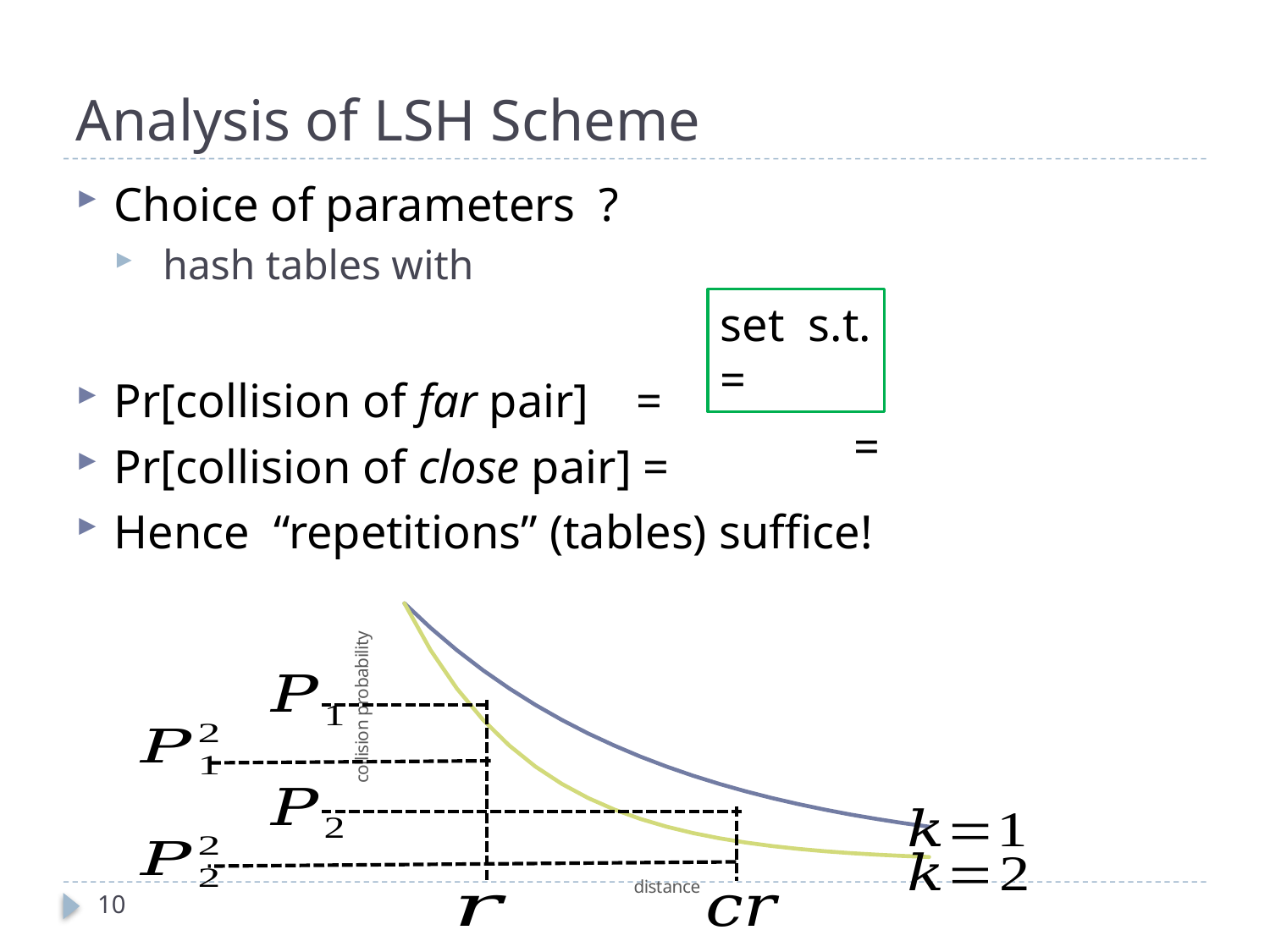
How many curves are plotted in the chart? 2 Which is larger on the chart, P1² or P2²? P1² What is the label of the y axis of the chart? collision probability Which curve passes through the point marked P2² at distance cr? k=2 What is the label of the x axis of the chart? distance Which curve drops off more steeply with distance, k=1 or k=2? k=2 Which is larger on the chart, P1 or P2? P1 As distance increases along the x axis, does collision probability rise or fall? fall Which curve passes through the point marked P1 at distance r? k=1 What kind of chart is shown at the bottom of the slide? line chart